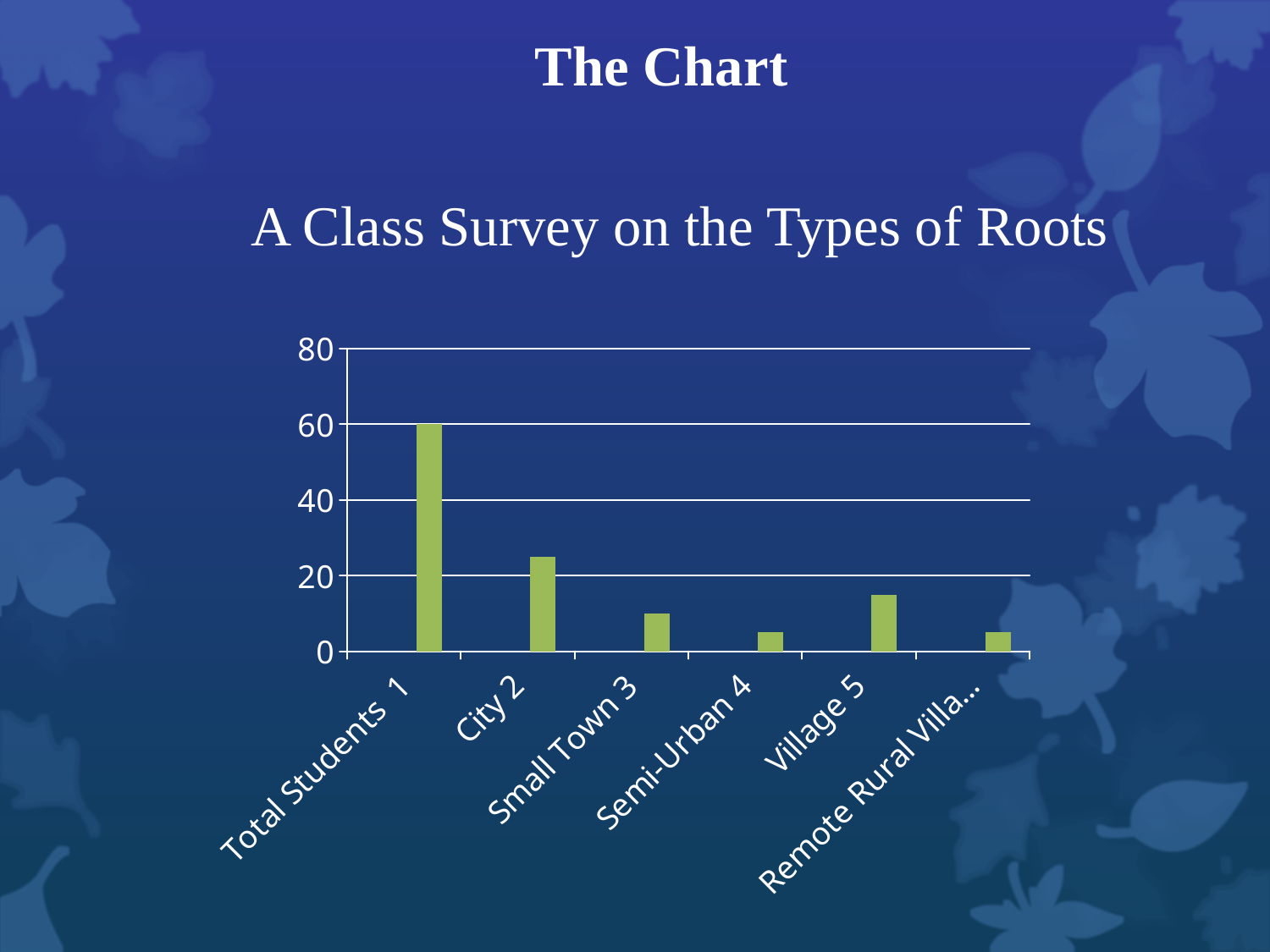
Is the value for City 2 greater or less than 20? greater Which category has the highest bar in the chart? Total Students 1 What kind of chart is shown on the slide? bar chart Is the value for Village 5 greater or less than 20? less What is the title of the chart on the slide? A Class Survey on the Types of Roots Which is larger, the value for City 2 or the value for Small Town 3? City 2 Is the value for Semi-Urban 4 greater or less than 20? less What is the highest value shown on the y axis of the chart? 80 How many categories are shown on the x axis of the chart? 6 What is the value for Total Students 1? 60 Which is larger, the value for Village 5 or the value for Semi-Urban 4? Village 5